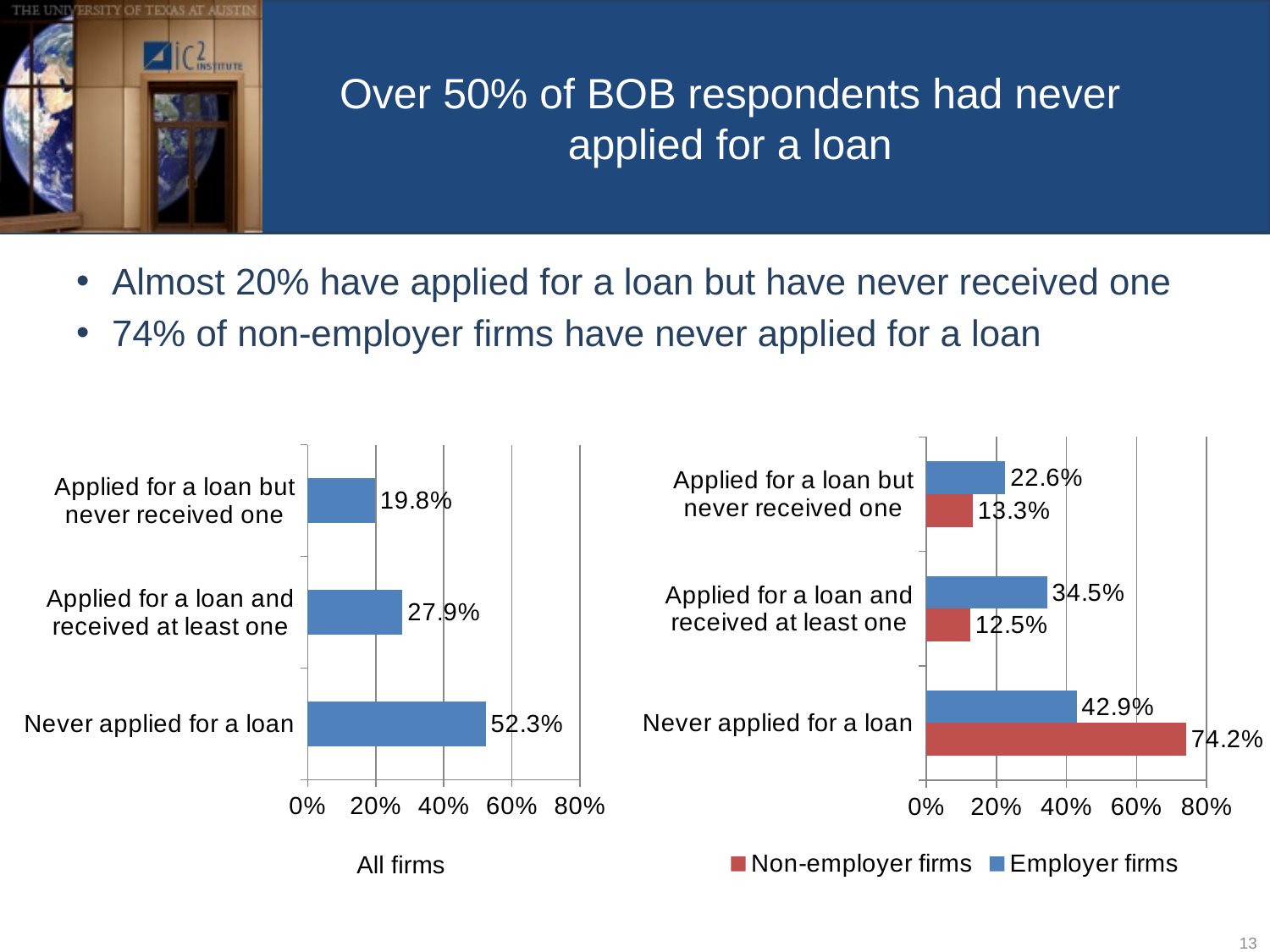
In the left chart (All firms), which category has the highest value? Never applied for a loan In the left chart (All firms), what percentage of firms never applied for a loan? 52.3% How many series does the legend of the right chart list? 2 What type of chart is the left chart? Bar chart In the right chart, which category has the lowest value for Non-employer firms? Applied for a loan and received at least one In the left chart (All firms), what is the difference between 'Applied for a loan and received at least one' and 'Applied for a loan but never received one'? 8.1% In the left chart (All firms), what percentage applied for a loan but never received one? 19.8% How many categories are shown in the left chart? 3 In the right chart, what is the difference between Non-employer firms and Employer firms for 'Never applied for a loan'? 31.3% In the right chart, what is the value for Employer firms that applied for a loan and received at least one? 34.5% In the right chart, which series has the larger value for 'Applied for a loan but never received one'? Employer firms In the right chart, what is the value for Non-employer firms that never applied for a loan? 74.2%